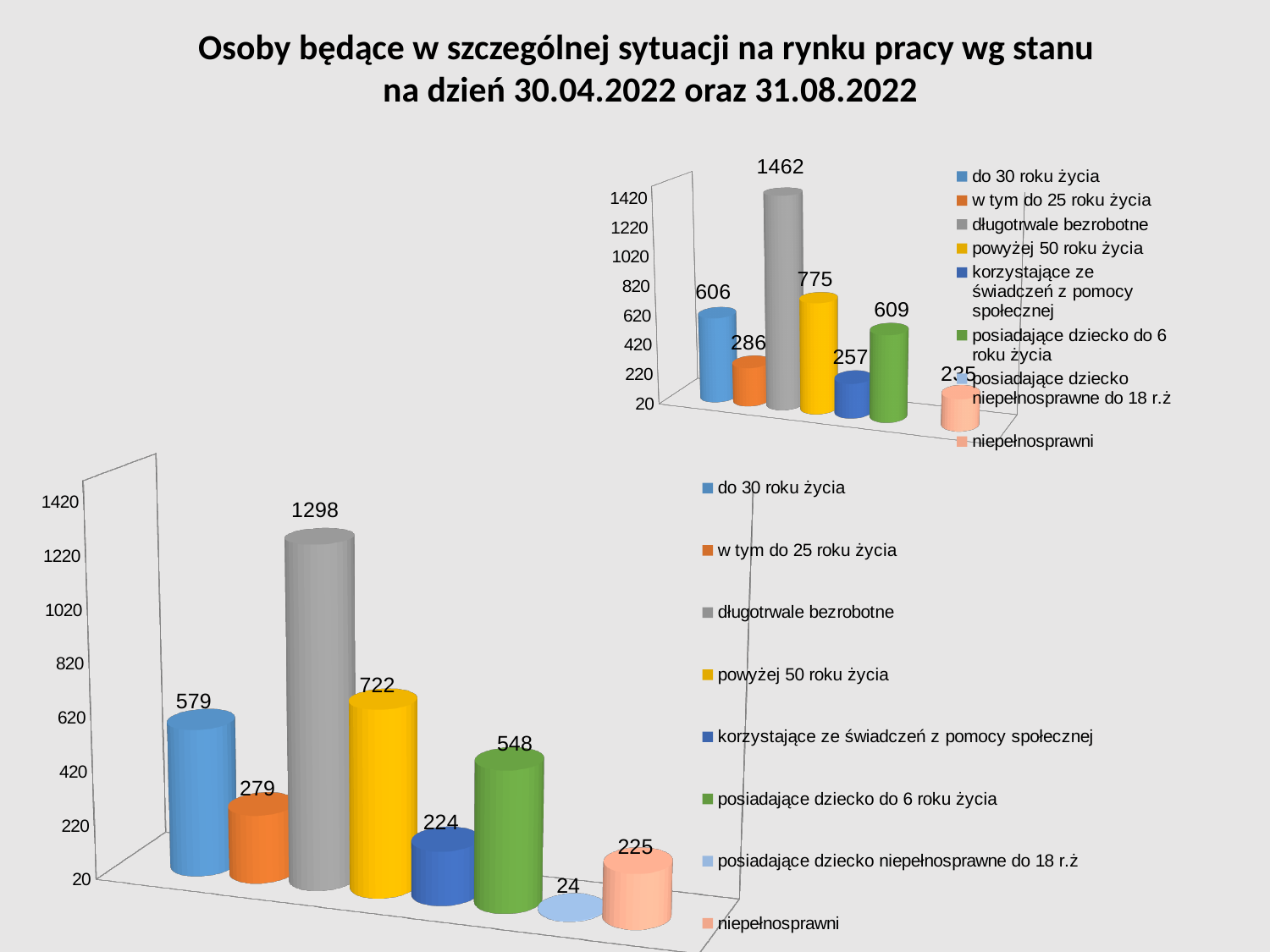
In the bottom-left chart, what is the difference between the values for do 30 roku życia and w tym do 25 roku życia? 300 In the bottom-left chart, what is the value for powyżej 50 roku życia? 722 What kind of chart is the bottom-left chart? bar chart In the top-right chart, what is the difference between the values for długotrwale bezrobotne and powyżej 50 roku życia? 687 In the bottom-left chart, which category has the lowest value? posiadające dziecko niepełnosprawne do 18 r.ż In the top-right chart, what is the value for długotrwale bezrobotne? 1462 In the bottom-left chart, what is the value for niepełnosprawni? 225 How many series does the legend of the bottom-left chart list? 8 In the bottom-left chart, which category has the highest value? długotrwale bezrobotne In the top-right chart, what is the value for powyżej 50 roku życia? 775 In the bottom-left chart, what is the value for długotrwale bezrobotne? 1298 In the top-right chart, what is the value for w tym do 25 roku życia? 286